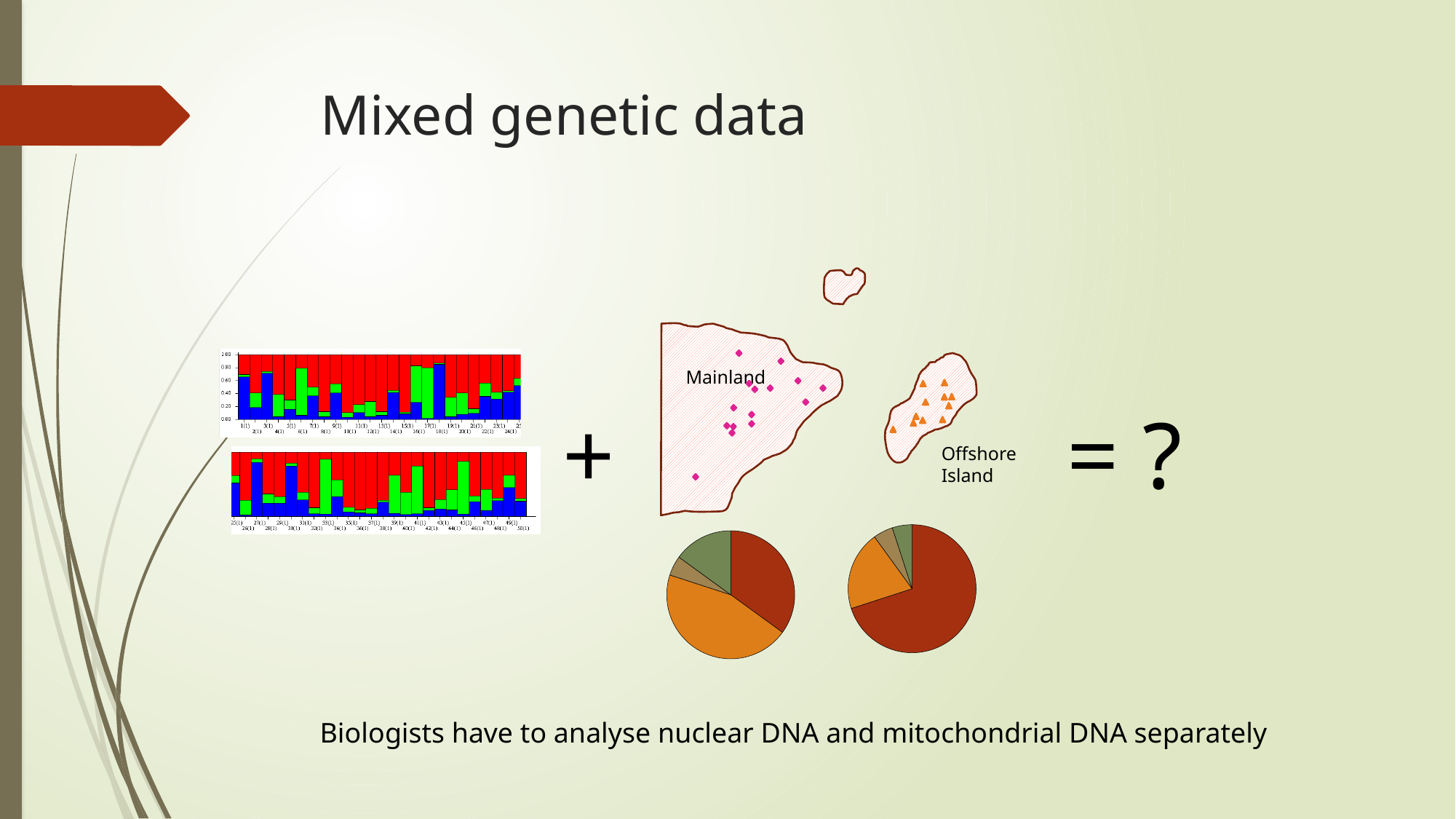
Which colour segment sits at the top of the bars in the stacked bar charts on the left? Red How many different colours make up each bar in the stacked bar charts on the left? 3 In the left pie chart, is the orange slice larger or smaller than the grey-green slice? Larger How many pie charts are shown on the slide? 2 How many slices does the left pie chart have? 4 How many slices does the right pie chart have? 4 In the left pie chart, which colour slice is the largest? Orange In the right pie chart, which colour slice is the largest? Dark red In the right pie chart, is the dark red slice larger or smaller than the orange slice? Larger What kind of chart are the two plots on the left side of the slide? Bar chart (stacked) What is the highest tick value on the y-axis of the upper stacked bar chart? 1.00